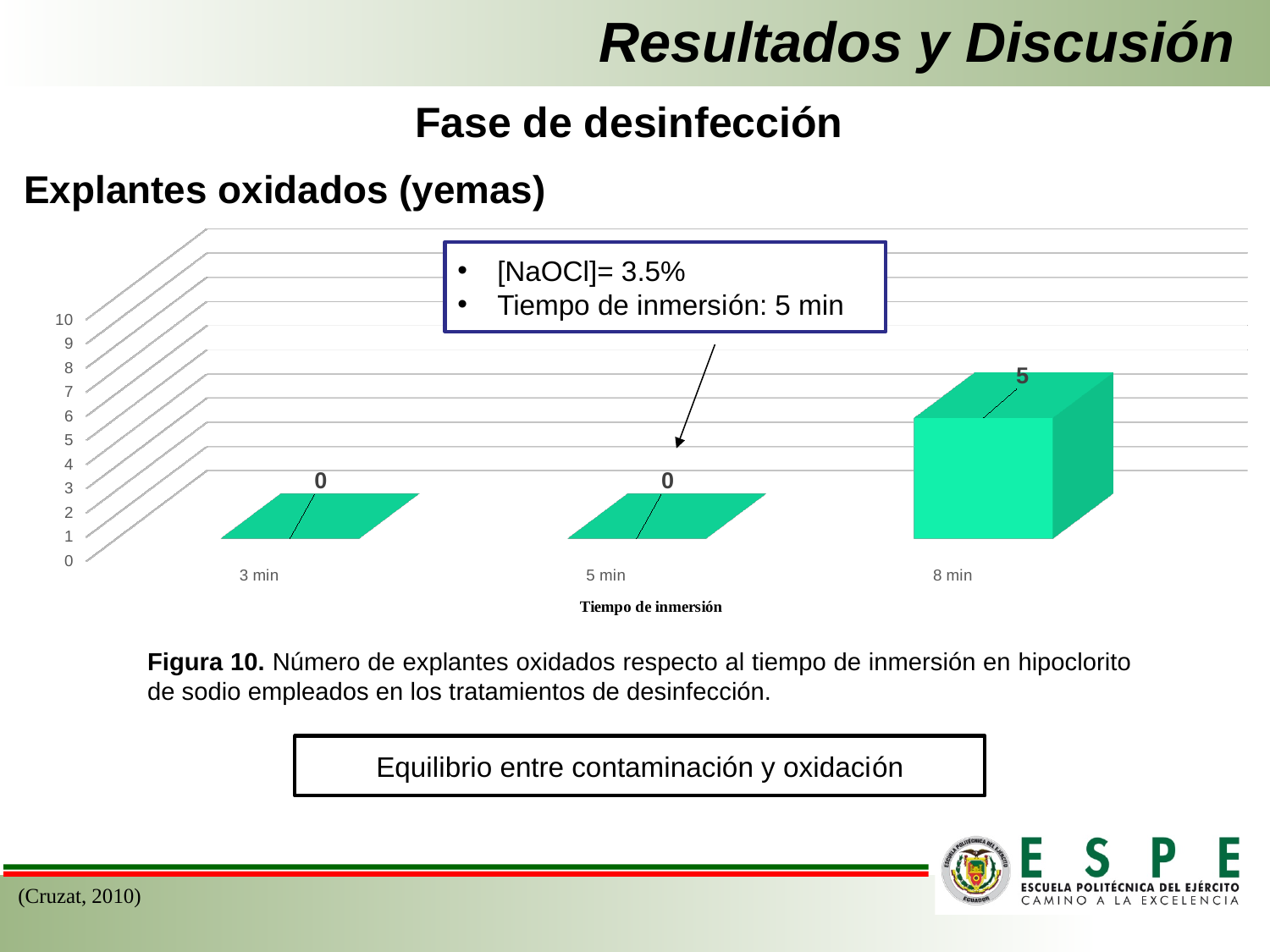
What is the number of oxidized explants for 3 min immersion time? 0 What is the number of oxidized explants for 8 min immersion time? 5 What is the number of oxidized explants for 5 min immersion time? 0 What is the difference between the values for 8 min and 5 min? 5 What is the maximum value shown on the y axis of the chart? 10 Do the values rise or fall from 5 min to 8 min along the x axis? rise What kind of chart is shown on the slide? bar chart Which immersion time has the highest number of oxidized explants? 8 min Which is larger, the value for 8 min or the value for 3 min? 8 min Is the value for 8 min greater or less than 3? greater What is the x-axis title of the chart? Tiempo de inmersión How many immersion time categories are shown on the x axis? 3